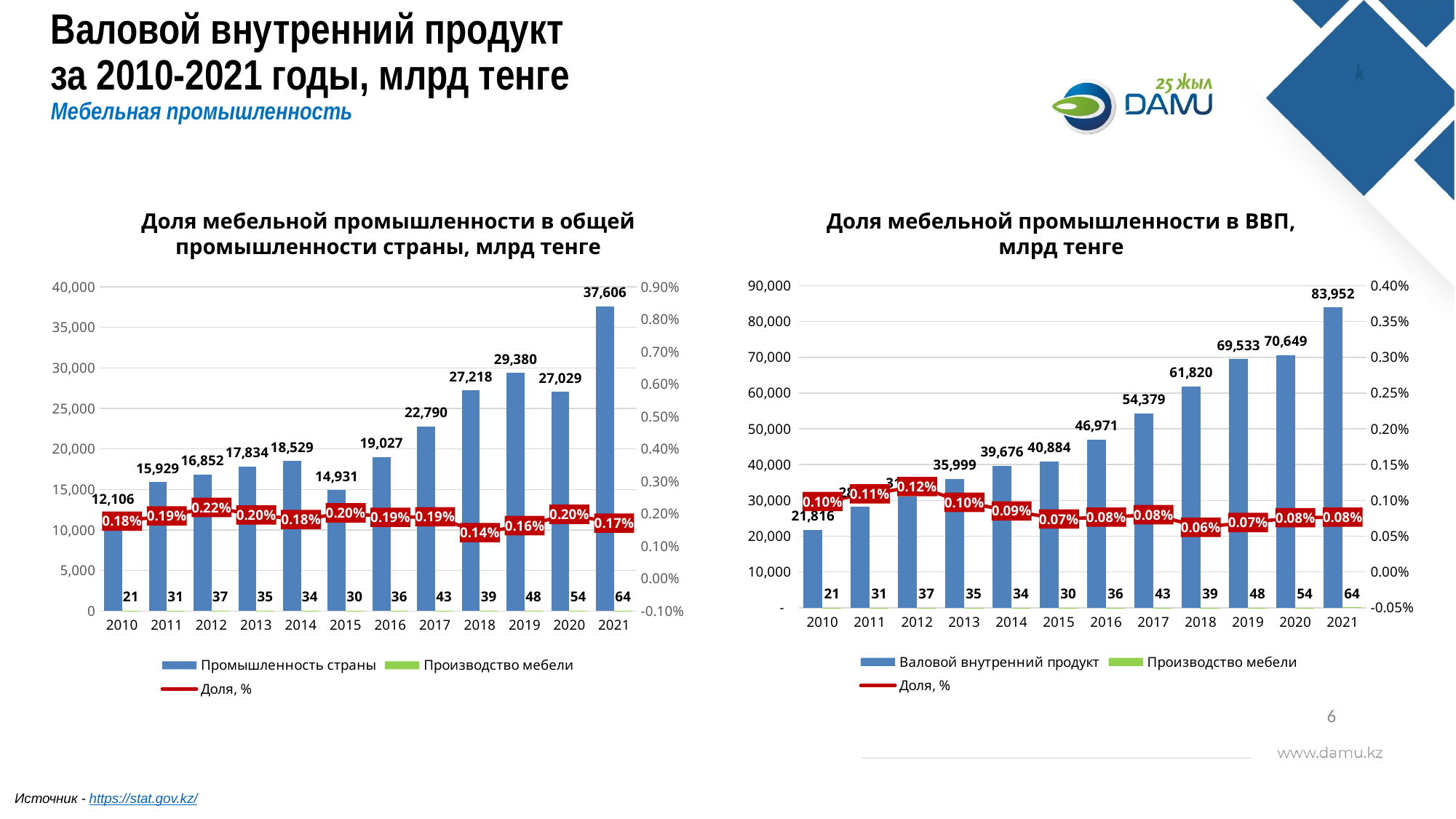
On the left chart, how many series does the legend list? 3 On the right chart, is the Валовой внутренний продукт value for 2019 greater or less than 60,000? greater On the right chart, what is the value of Производство мебели for 2021? 64 On the left chart (Доля мебельной промышленности в общей промышленности страны), what is the value of Промышленность страны for 2021? 37,606 On the right chart, what is the Доля, % value for 2018? 0.06% On the left chart, which year has the lowest Доля, % value? 2018 On the left chart, what is the Доля, % value for 2012? 0.22% On the right chart, what is the value of Валовой внутренний продукт for 2017? 54,379 On the left chart, what is the difference between the Промышленность страны values for 2021 and 2020? 10,577 On the right chart, which year has the highest Валовой внутренний продукт value? 2021 On the left chart, what is the value of Промышленность страны for 2015? 14,931 On the right chart (Доля мебельной промышленности в ВВП), what is the value of Валовой внутренний продукт for 2021? 83,952